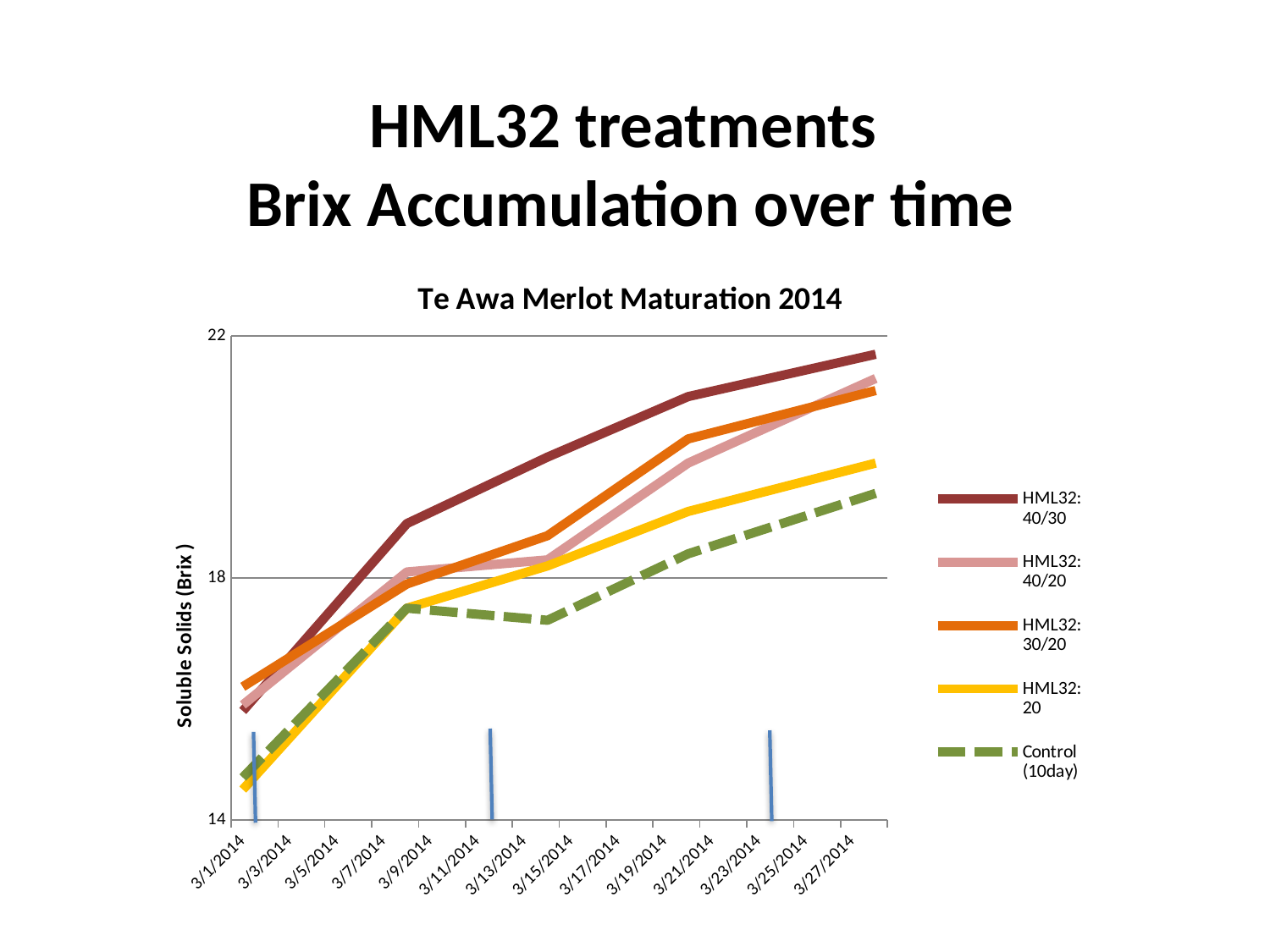
What is the title of the chart? Te Awa Merlot Maturation 2014 What is the label of the vertical axis? Soluble Solids (Brix ) Does the HML32: 40/30 series rise or fall from 3/1/2014 to 3/27/2014? Rise Is the value for HML32: 40/30 at 3/27/2014 greater or less than 18? greater Is the value for Control (10day) at 3/13/2014 greater or less than 18? less At 3/21/2014, which is higher: HML32: 30/20 or HML32: 20? HML32: 30/20 Which series is highest at 3/27/2014? HML32: 40/30 Which series is lowest at 3/27/2014? Control (10day) Is the value for HML32: 20 at 3/1/2014 greater or less than 18? less How many date labels are shown on the x axis? 14 How many series does the legend list? 5 What kind of chart is shown on the slide? Line chart